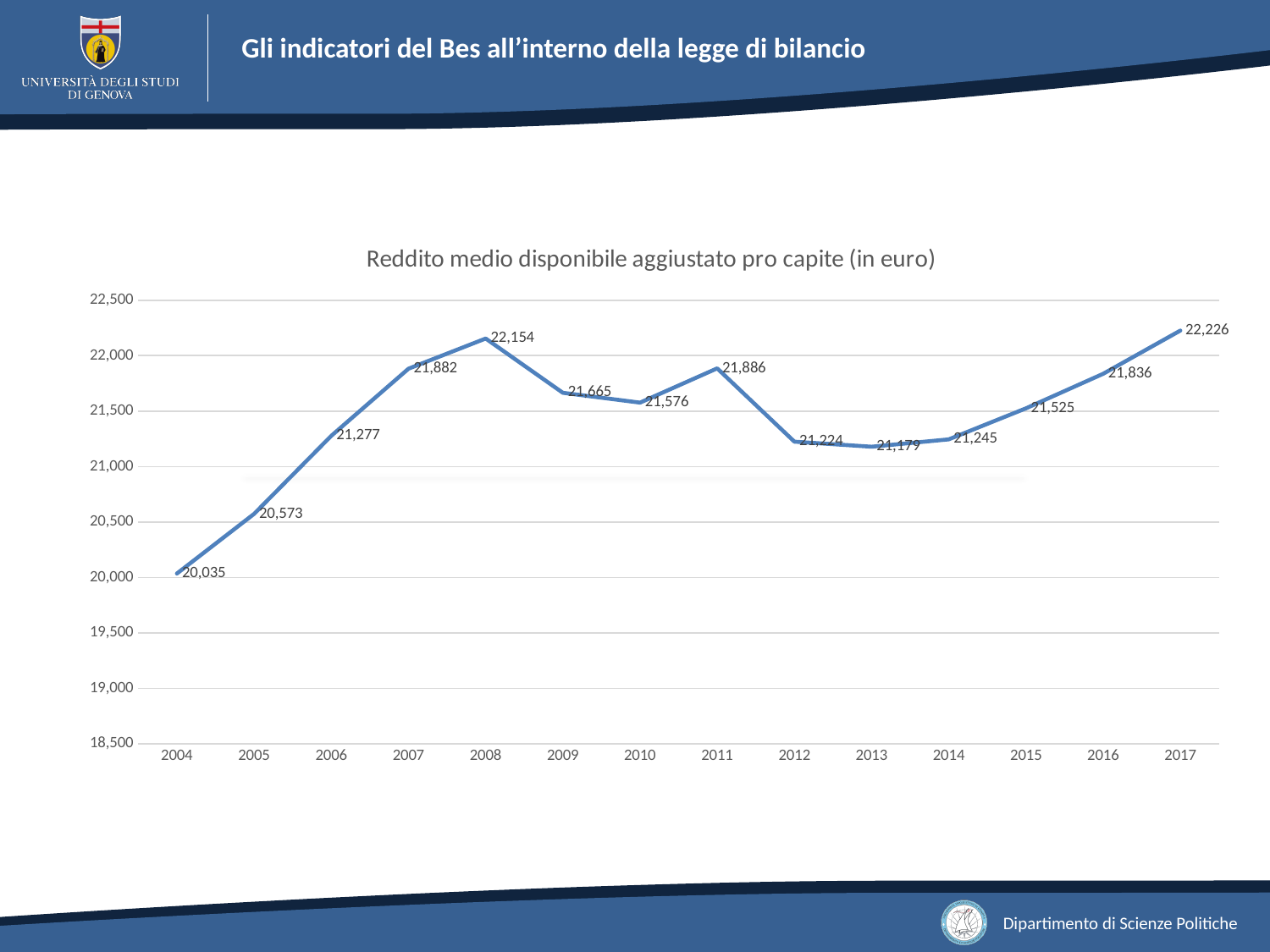
What is the title of the chart? Reddito medio disponibile aggiustato pro capite (in euro) Which is larger, the value for 2008 or the value for 2011? 2008 What is the value for 2004? 20,035 Which year has the highest value? 2017 What kind of chart is shown? line chart What is the difference between the values for 2008 and 2009? 489 What is the value for 2011? 21,886 What is the difference between the values for 2017 and 2004? 2,191 Which year has the lowest value? 2004 What is the value for 2013? 21,179 How many years are plotted on the x axis? 14 Is the value for 2006 greater or less than 21,000? greater